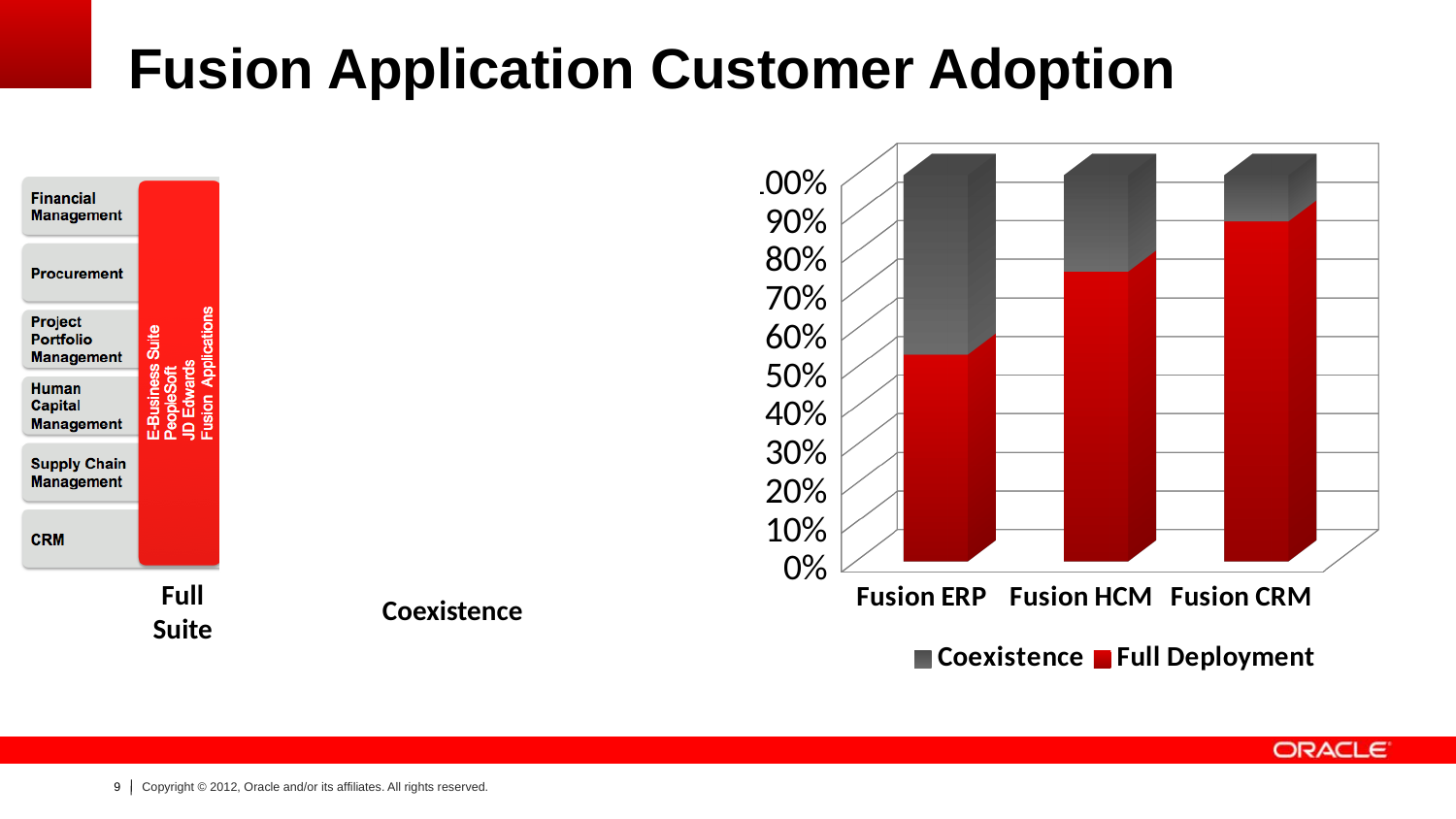
What kind of chart is shown on the slide? Stacked bar chart Which category has the lowest Full Deployment value? Fusion ERP How many series does the chart's legend list? 2 Which colour represents Full Deployment in the chart? Red How many categories are shown on the x axis of the chart? 3 Is the Full Deployment value for Fusion ERP greater or less than 70%? less Is the Full Deployment value for Fusion CRM greater or less than 80%? greater Which has a larger Full Deployment value, Fusion HCM or Fusion ERP? Fusion HCM Which category has the highest Full Deployment value? Fusion CRM Does the Full Deployment value rise or fall from Fusion ERP to Fusion CRM? rise Which category has the largest Coexistence share? Fusion ERP Is the Full Deployment value for Fusion HCM greater or less than 60%? greater